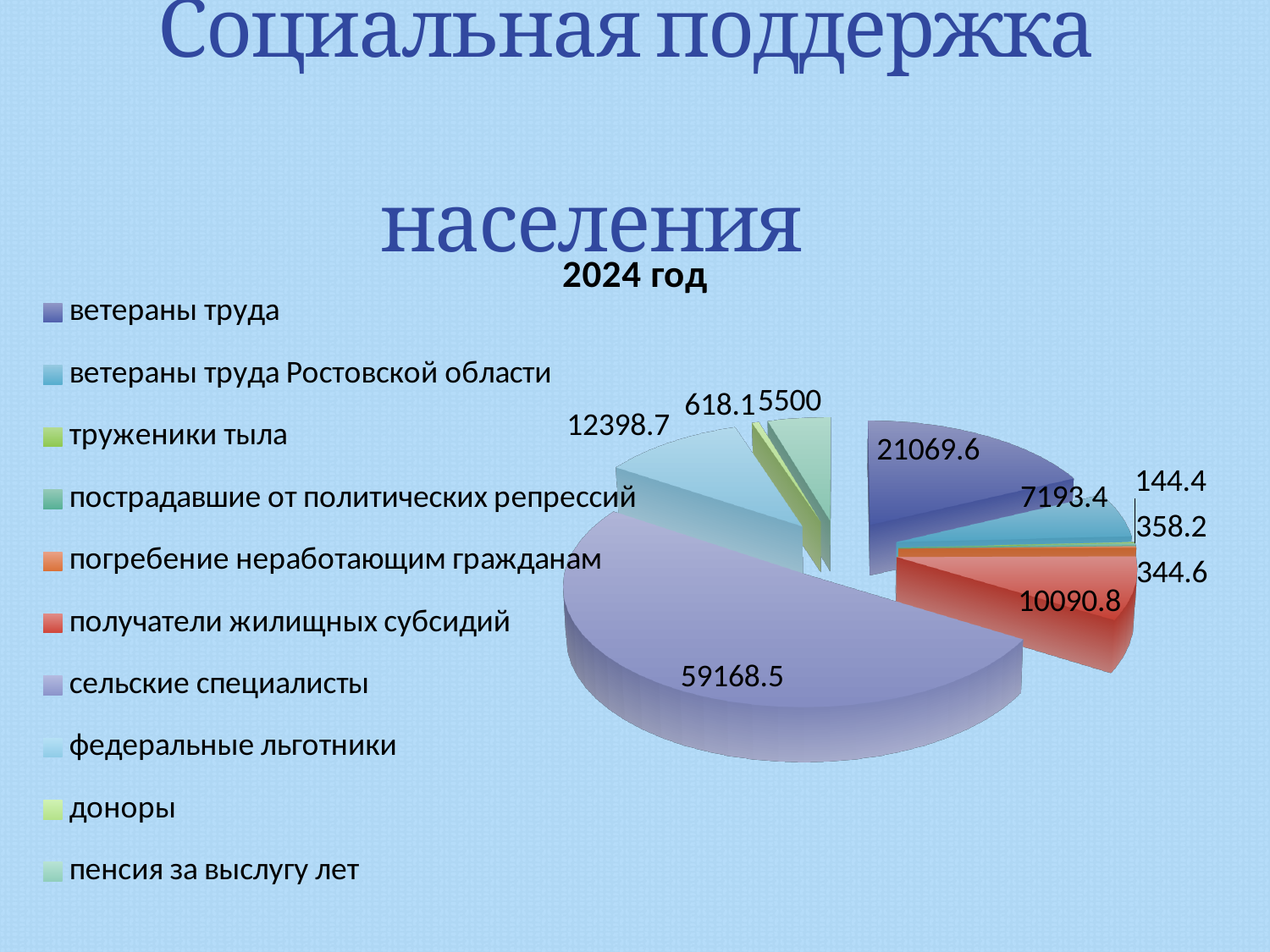
Which is larger, the value for федеральные льготники or the value for получатели жилищных субсидий? федеральные льготники What is the value for сельские специалисты? 59168.5 What is the difference between the values for сельские специалисты and ветераны труда? 38098.9 What is the value for федеральные льготники? 12398.7 Which category has the largest slice of the pie? сельские специалисты What is the value for получатели жилищных субсидий? 10090.8 What is the smallest value labelled on the chart? 144.4 What kind of chart is shown on the slide? pie chart How many categories does the chart legend list? 10 What is the title of the chart? 2024 год What is the value for ветераны труда Ростовской области? 7193.4 What is the value for ветераны труда? 21069.6